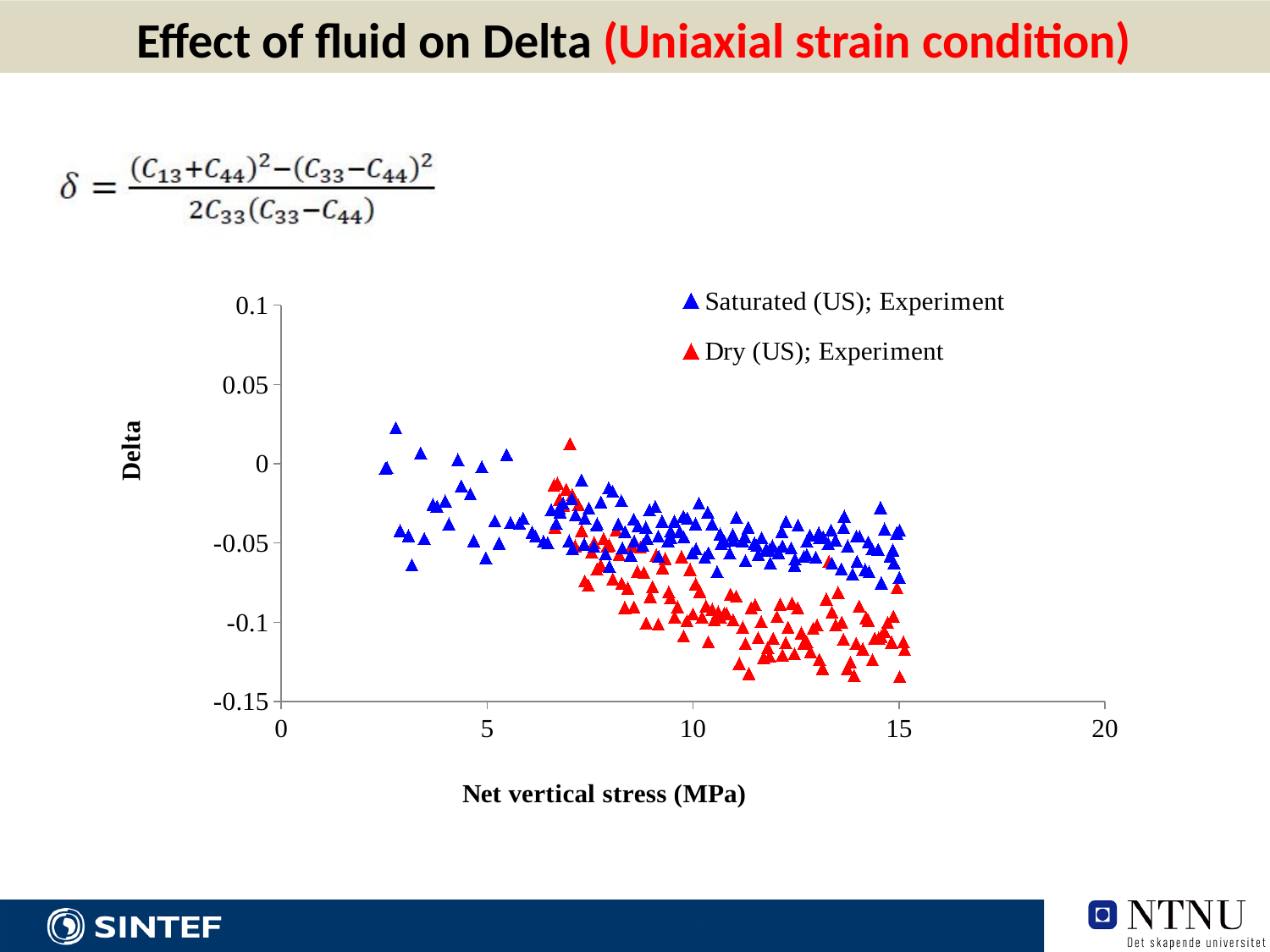
What is the label of the y axis? Delta What kind of chart is shown on the slide? Scatter chart What is the maximum value shown on the y axis? 0.1 How many series does the legend list? 2 Are the Dry (US); Experiment Delta values at around 14 MPa greater or less than 0? less Are the Dry (US); Experiment Delta values at around 12 MPa greater or less than -0.05? less Do the Dry (US); Experiment values rise or fall as net vertical stress increases? Fall Which series has the lowest Delta values overall, Saturated (US); Experiment or Dry (US); Experiment? Dry (US); Experiment What is the label of the x axis? Net vertical stress (MPa) At a net vertical stress of about 12 MPa, which series has the higher Delta values, Saturated (US); Experiment or Dry (US); Experiment? Saturated (US); Experiment Are the Saturated (US); Experiment Delta values at around 10 MPa greater or less than -0.1? greater